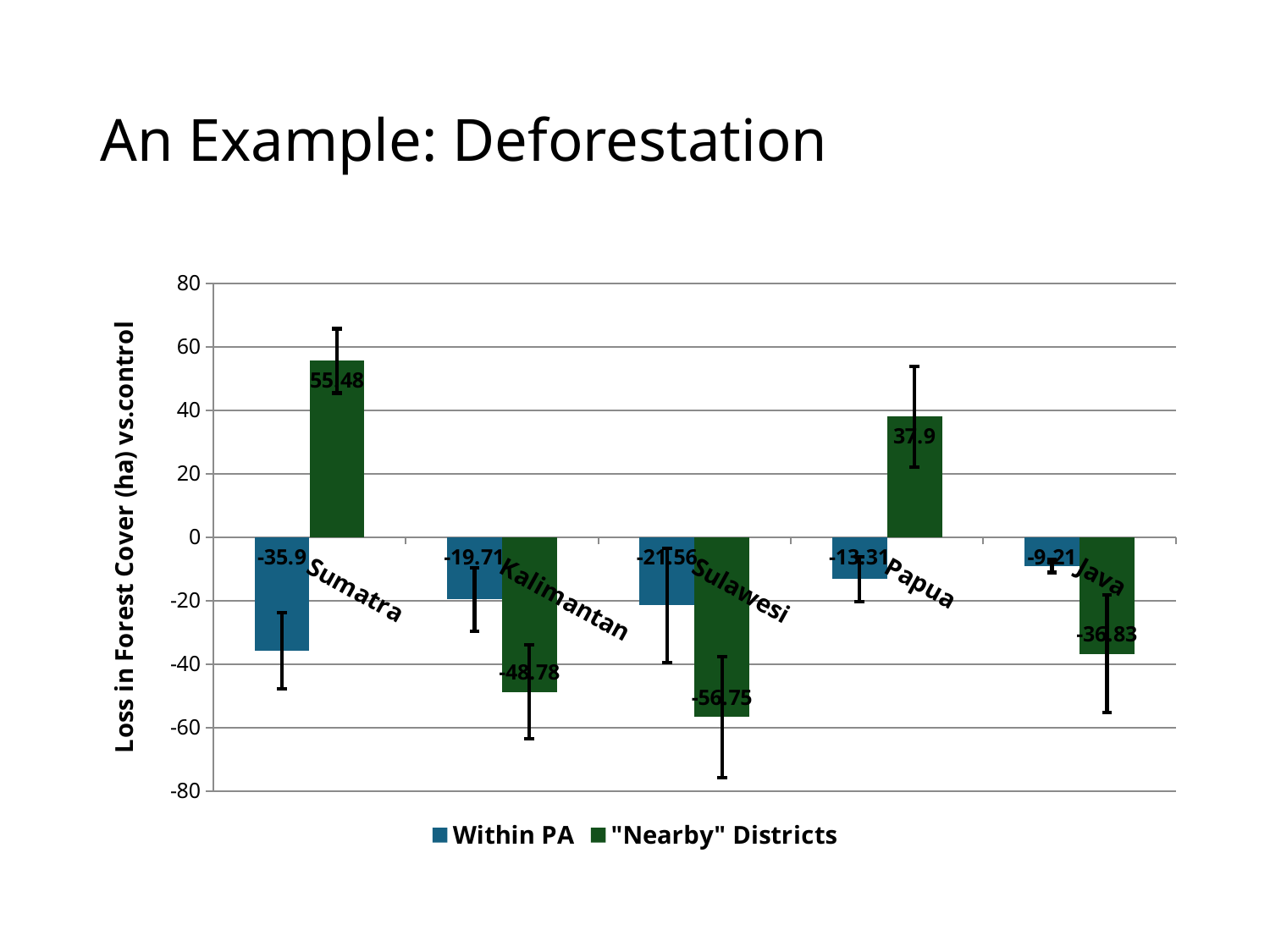
How many regions are shown on the x axis? 5 Which region has the lowest Within PA value? Sumatra What is the Within PA value for Kalimantan? -19.71 Which is larger, the Within PA value for Sulawesi or the Within PA value for Java? Java What is the Within PA value for Papua? -13.31 How many series does the legend list? 2 What is the difference between the "Nearby" Districts value for Sumatra and for Papua? 17.58 Which region has the lowest "Nearby" Districts value? Sulawesi What type of chart is shown on the slide? Bar chart What is the "Nearby" Districts value for Java? -36.83 What is the "Nearby" Districts value for Sumatra? 55.48 Which region has the highest "Nearby" Districts value? Sumatra